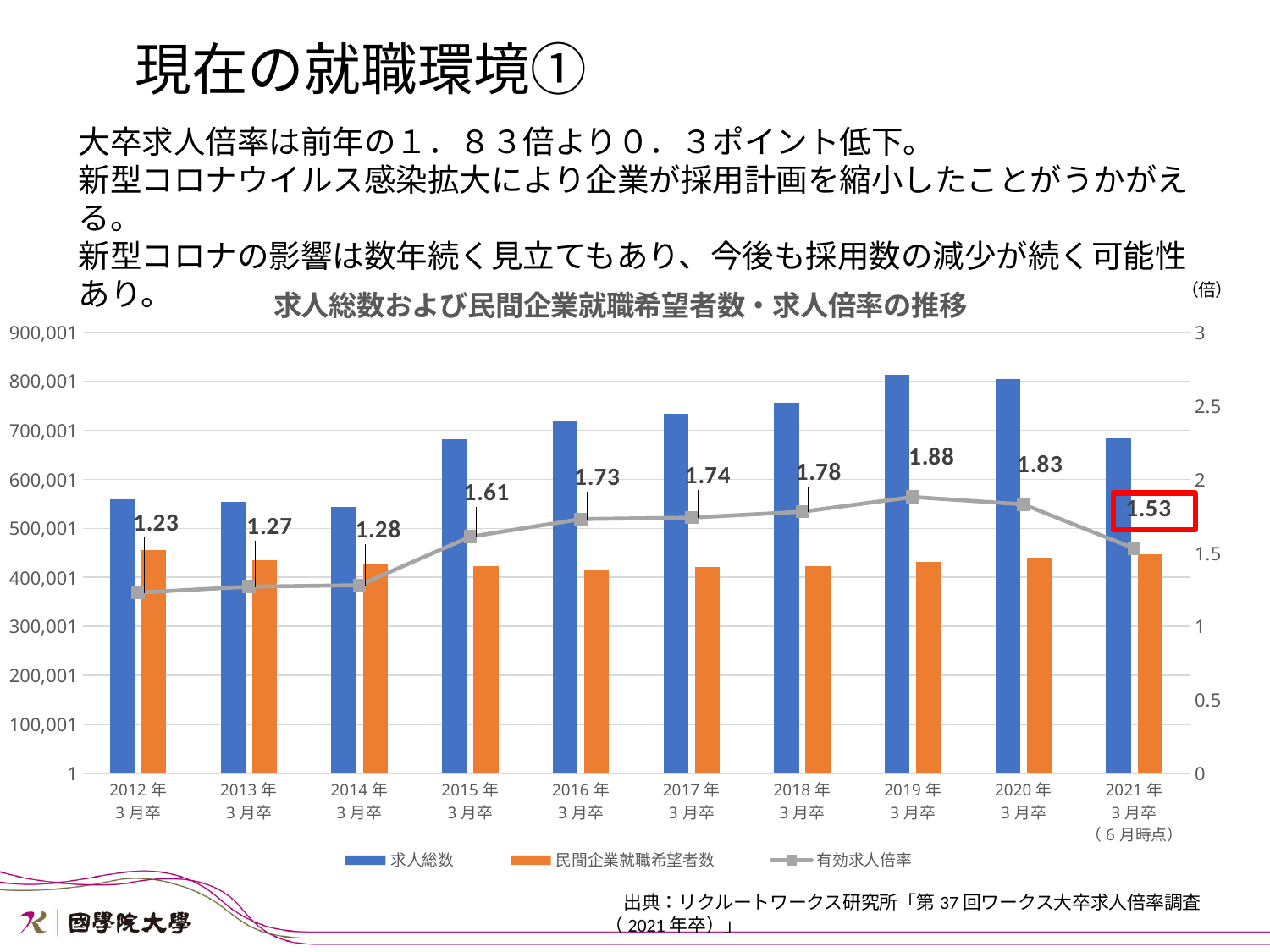
How many series does the legend list? 3 What is the 有効求人倍率 value for 2019年3月卒? 1.88 What kind of chart is this? Combination bar and line chart What is the 有効求人倍率 value for 2021年3月卒? 1.53 Which year has the lowest 有効求人倍率? 2012年3月卒 What is the 有効求人倍率 value for 2015年3月卒? 1.61 Is the 民間企業就職希望者数 bar for 2016年3月卒 greater or less than 500,001? less Is the 求人総数 bar for 2012年3月卒 greater or less than 500,001? greater Which year has the highest 有効求人倍率? 2019年3月卒 Which is larger, the 有効求人倍率 for 2016年3月卒 or for 2021年3月卒? 2016年3月卒 How many years (categories) are shown on the x axis? 10 By how much did the 有効求人倍率 fall from 2020年3月卒 to 2021年3月卒? 0.3